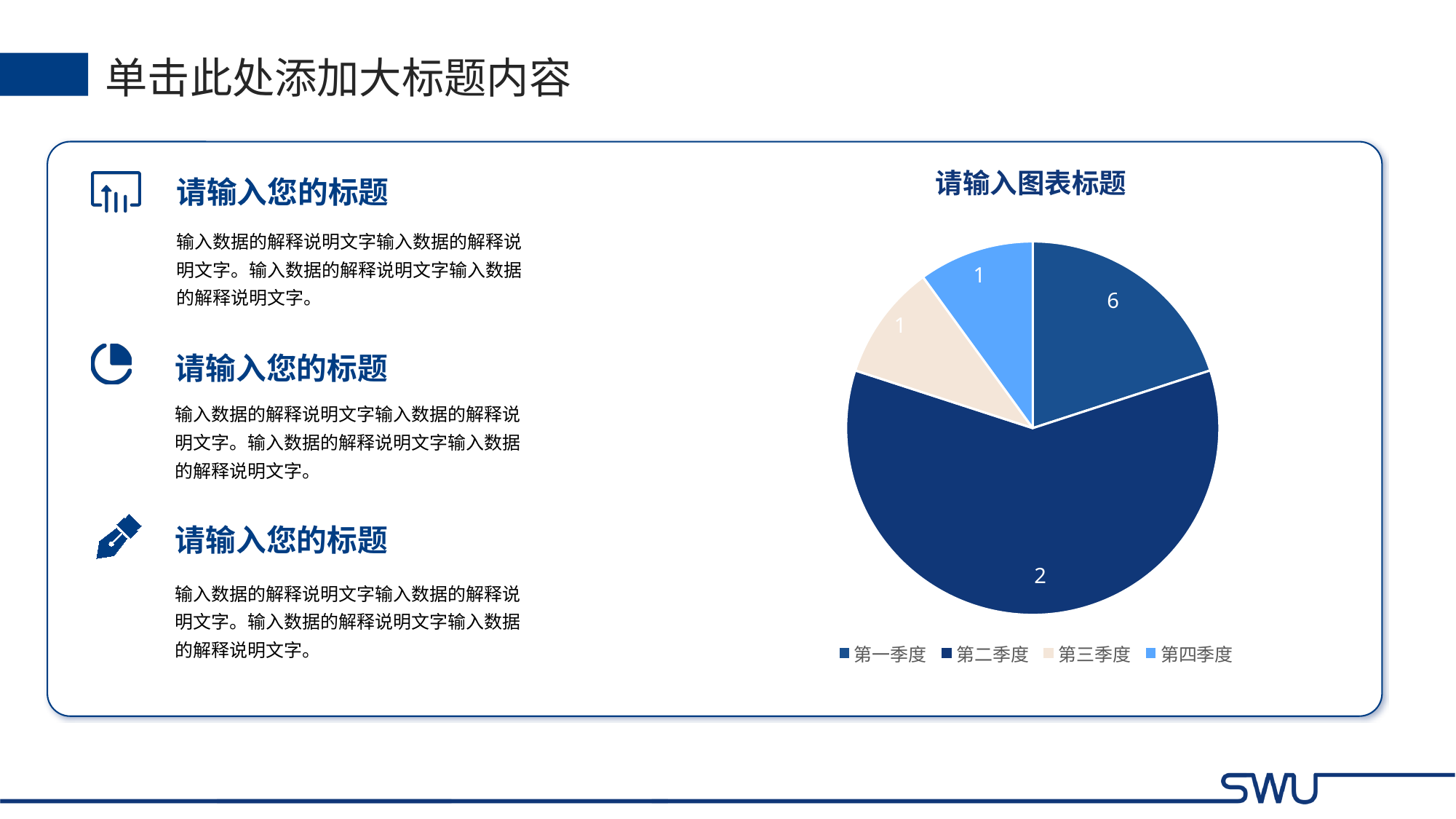
How many entries does the chart legend list? 4 What kind of chart is shown on the slide? pie chart What is the title of the chart? 请输入图表标题 How many slices does the pie chart have? 4 What data label is shown on the 第一季度 slice? 6 Which legend entry is shown in the light beige colour? 第三季度 What data label is shown on the 第三季度 slice? 1 What data label is shown on the 第四季度 slice? 1 What data label is shown on the 第二季度 slice? 2